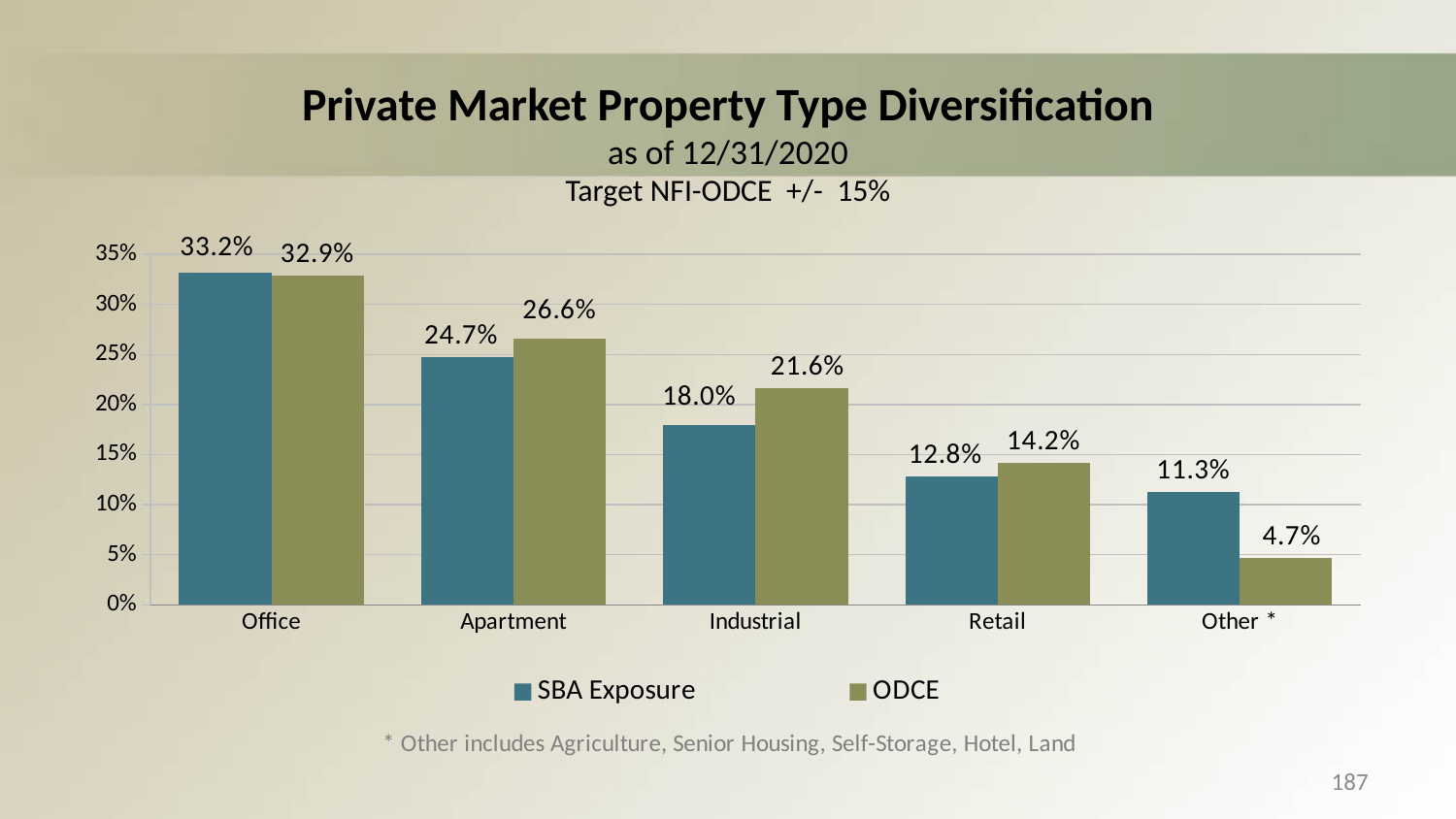
What is the SBA Exposure value for Office? 33.2% Which property type has the highest SBA Exposure value? Office What is the ODCE value for Other *? 4.7% How many property type categories are shown on the x axis? 5 Is the SBA Exposure value for Apartment greater or less than 20%? greater Which property type has the lowest ODCE value? Other * How many series does the legend list? 2 What is the difference between the SBA Exposure and ODCE values for Industrial? 3.6% Do the SBA Exposure values rise or fall from Office to Other * along the x axis? Fall What is the ODCE value for Apartment? 26.6% For Retail, which is larger: SBA Exposure or ODCE? ODCE What kind of chart is shown on the slide? Bar chart